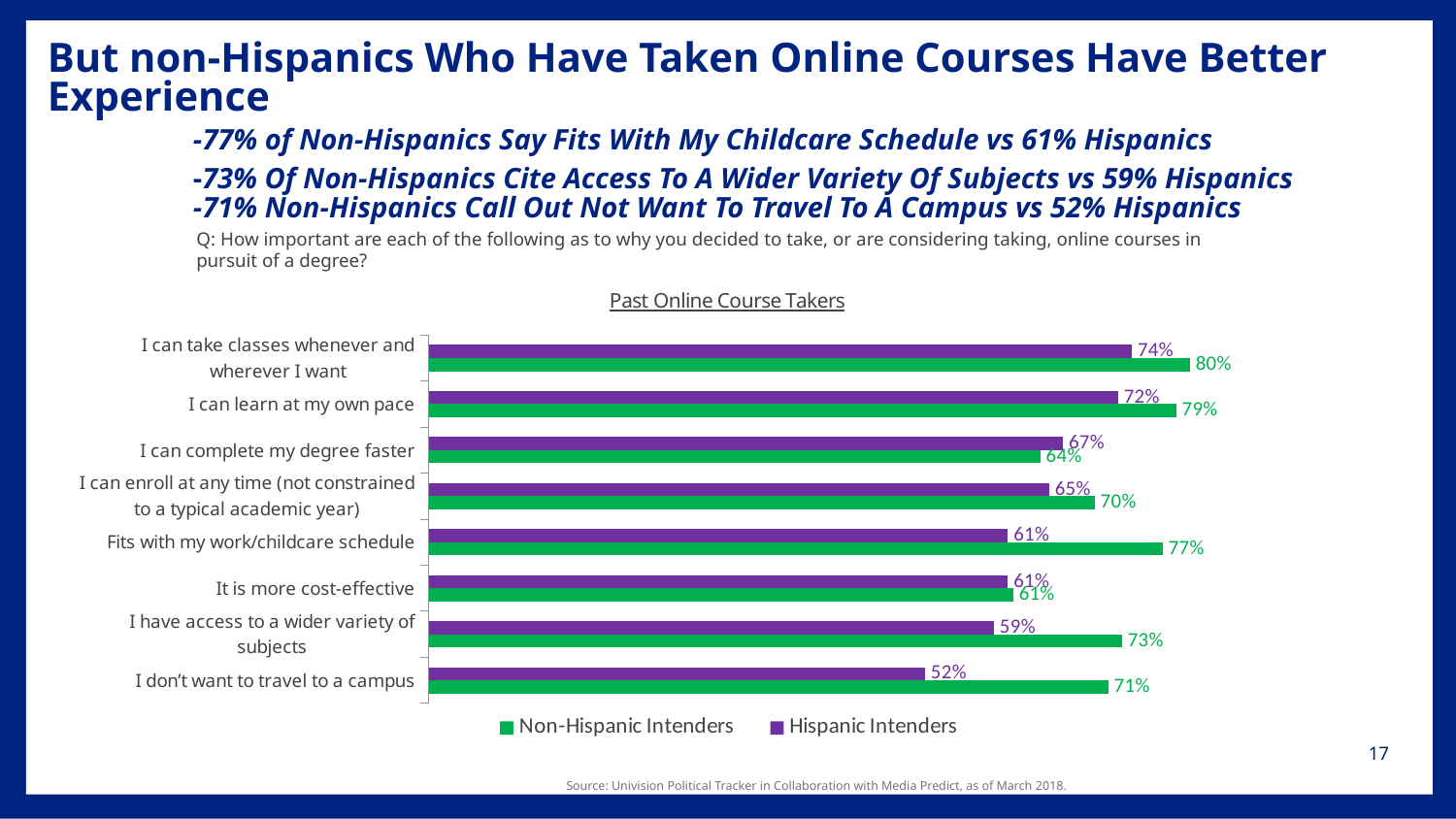
Which category has the lowest value for Non-Hispanic Intenders? It is more cost-effective What is the value for Hispanic Intenders for "I can complete my degree faster"? 67% Which colour represents Hispanic Intenders in the chart? Purple For "I can complete my degree faster", which group has the larger value, Hispanic Intenders or Non-Hispanic Intenders? Hispanic Intenders Which category has the highest value for Hispanic Intenders? I can take classes whenever and wherever I want What percentage of Hispanic Intenders say "I don't want to travel to a campus"? 52% How many series does the legend list? 2 What percentage of Non-Hispanic Intenders say "I can take classes whenever and wherever I want"? 80% What type of chart is shown on the slide? Bar chart What is the difference between Non-Hispanic Intenders and Hispanic Intenders for "Fits with my work/childcare schedule"? 16 percentage points How many categories are shown on the chart? 8 What is the title of the chart? Past Online Course Takers